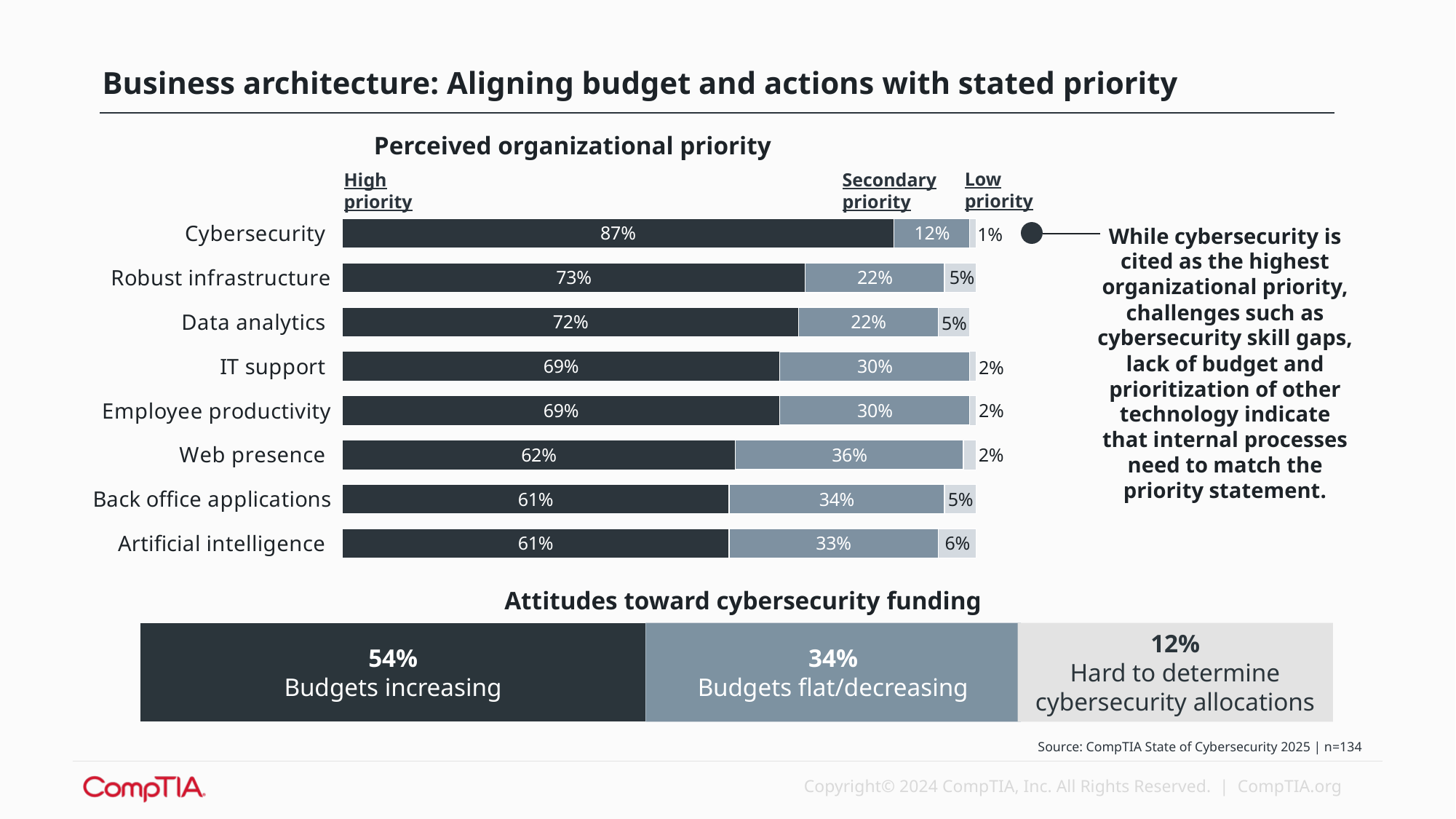
In the Attitudes toward cybersecurity funding chart, what is the difference between budgets increasing and budgets flat/decreasing? 20% In the Perceived organizational priority chart, which category has the highest high priority value? Cybersecurity In the Perceived organizational priority chart, which has a larger high priority value, Data analytics or Web presence? Data analytics How many series does the Perceived organizational priority chart show? 3 What kind of chart is the Perceived organizational priority chart? Stacked bar chart How many categories are shown in the Perceived organizational priority chart? 8 In the Perceived organizational priority chart, what percentage rate cybersecurity as a high priority? 87% In the Perceived organizational priority chart, which category has the lowest secondary priority value? Cybersecurity In the Perceived organizational priority chart, what is the secondary priority value for Web presence? 36% In the Perceived organizational priority chart, what is the low priority value for Artificial intelligence? 6% In the Perceived organizational priority chart, what is the difference between the high priority values for Cybersecurity and Robust infrastructure? 14% In the Attitudes toward cybersecurity funding chart, what percentage report budgets increasing? 54%